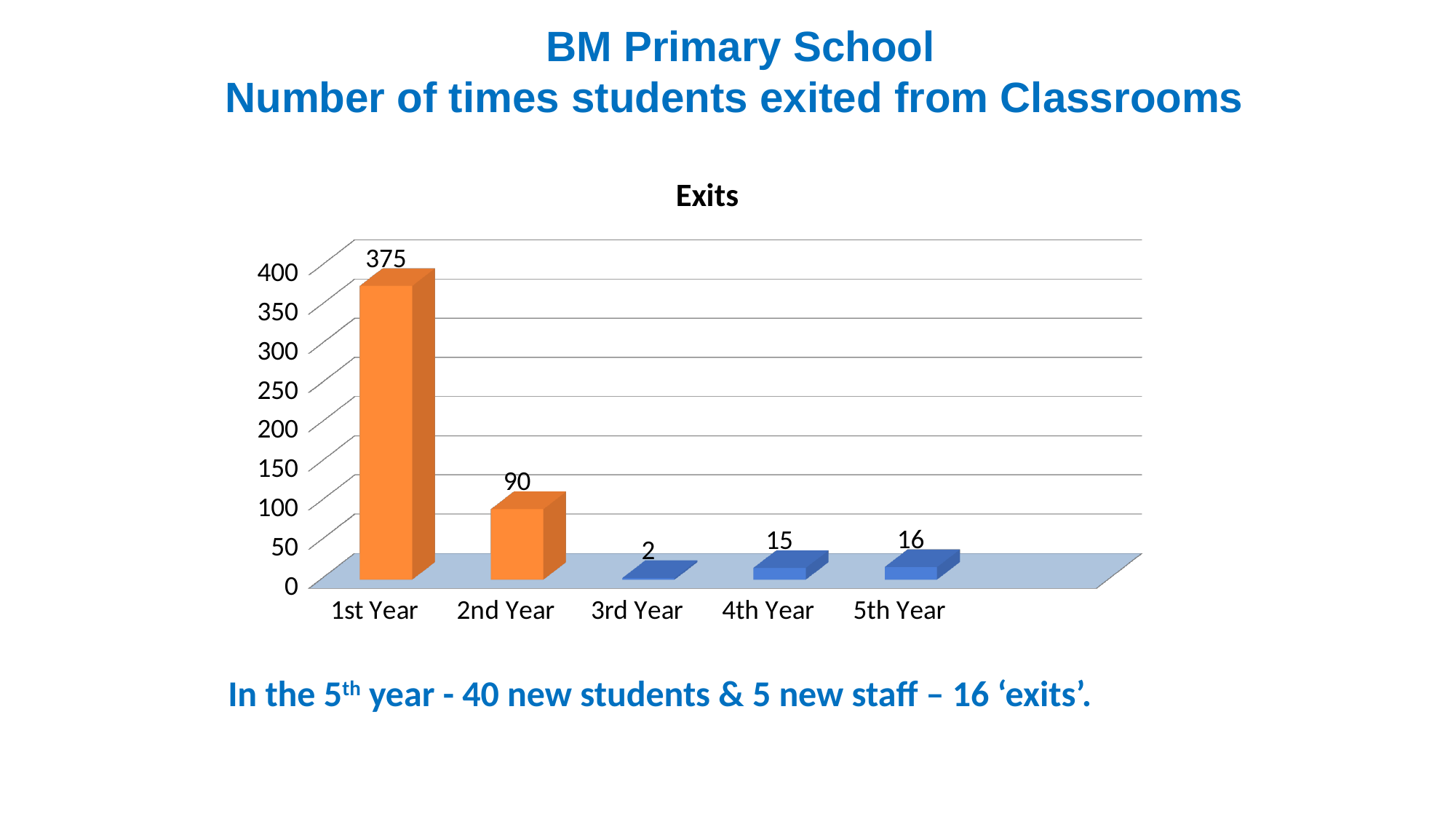
Which year has the highest number of exits? 1st Year What is the difference between the values for 5th Year and 4th Year? 1 What is the value for 5th Year? 16 What kind of chart is shown? Bar chart How many years are shown on the x axis? 5 What is the value for 3rd Year? 2 What is the difference between the values for 1st Year and 2nd Year? 285 What is the title of the chart? Exits Which year has the lowest number of exits? 3rd Year Which is larger, the value for 2nd Year or the value for 4th Year? 2nd Year What is the value for 1st Year? 375 What is the value for 2nd Year? 90